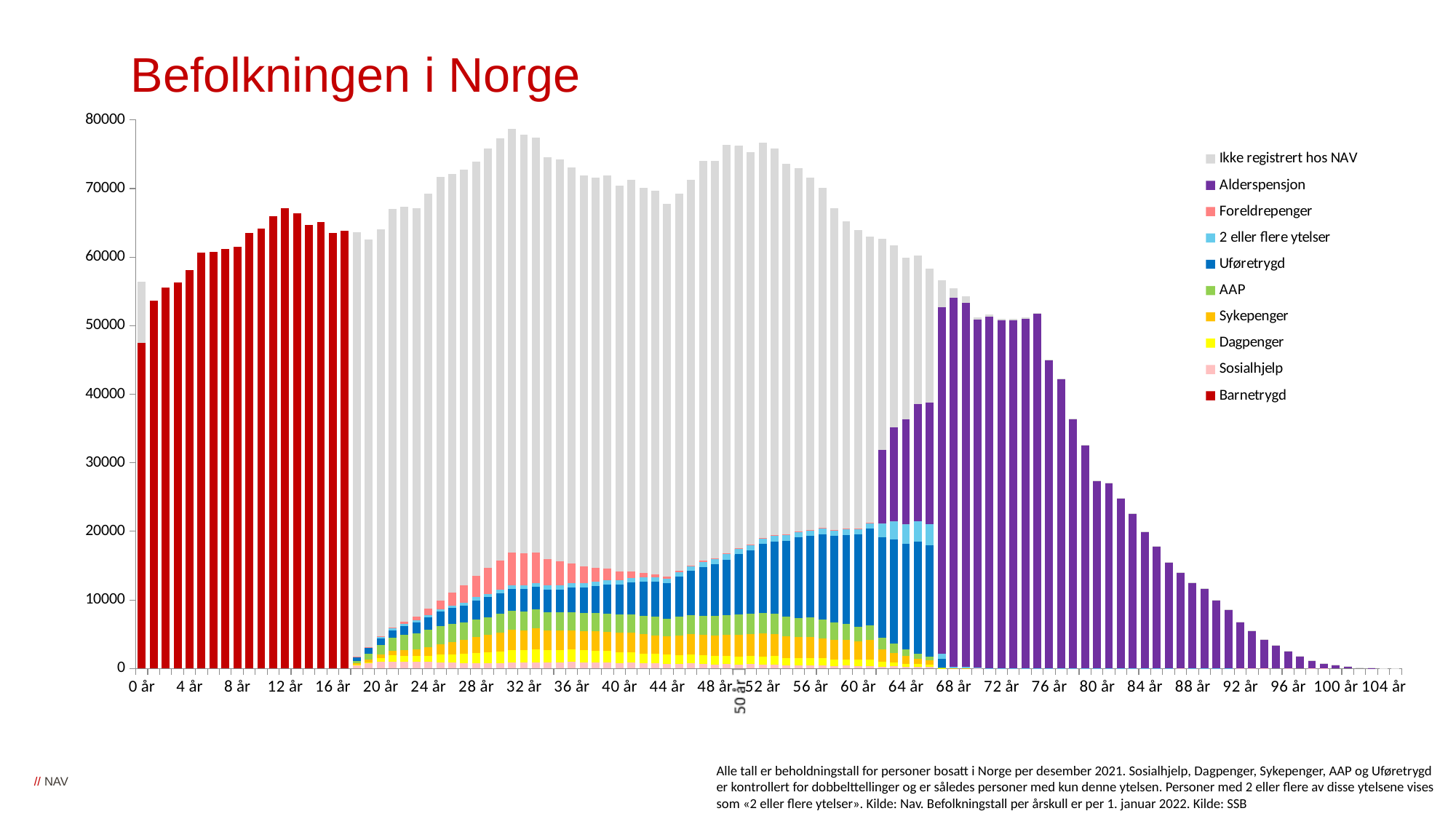
Is the total value for 0 år greater or less than 50000? greater Which series is shown in purple in the legend? Alderspensjon Do the total values rise or fall along the x axis from 84 år to 104 år? fall Is the total value for 32 år greater or less than 70000? greater Is the total value for 12 år greater or less than 60000? greater What kind of chart is shown on the slide? Stacked bar chart How many series does the legend list? 10 What is the title of the chart? Befolkningen i Norge Which has the larger total value, 76 år or 80 år? 76 år Which has the larger total value, 0 år or 12 år? 12 år